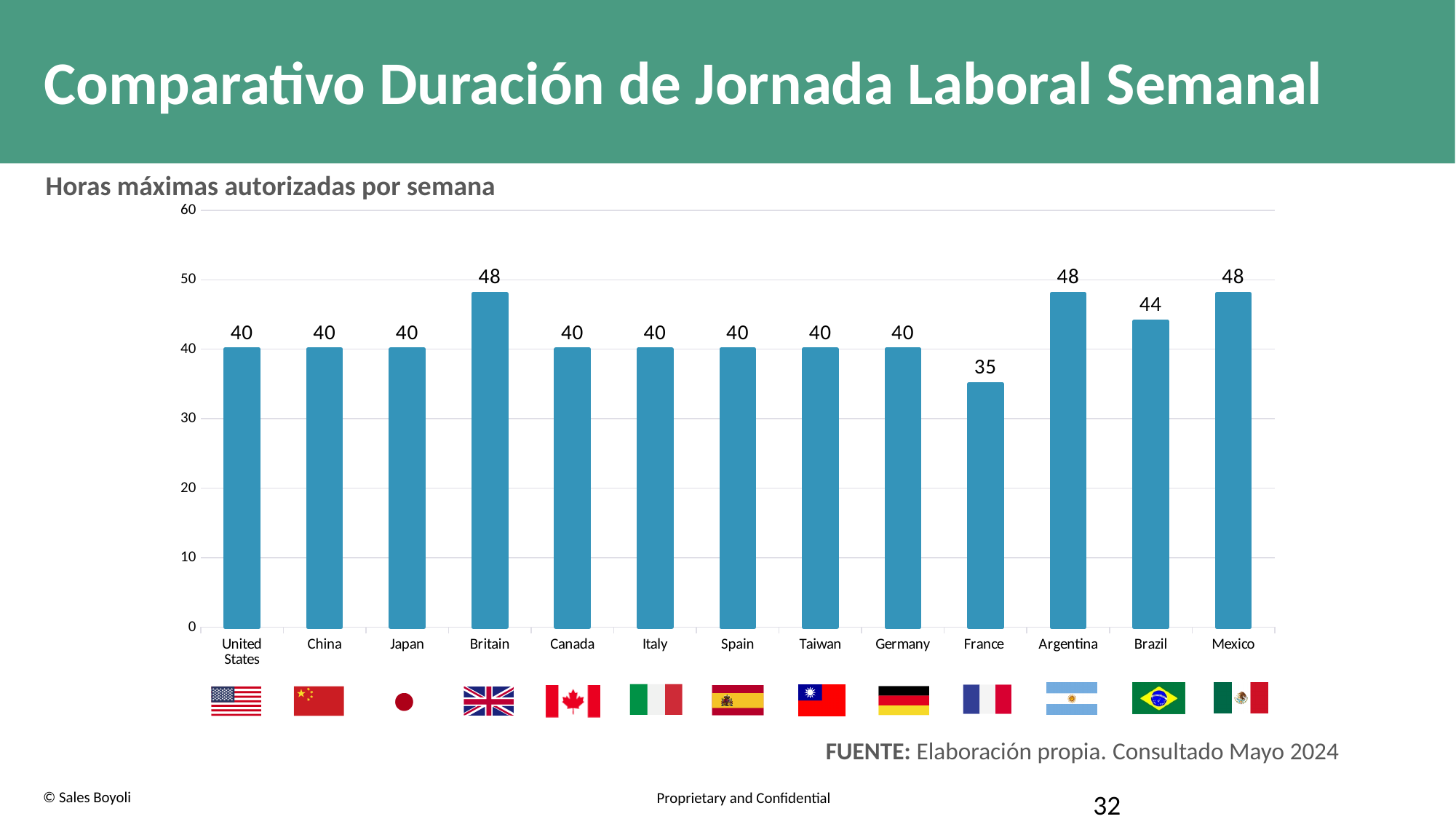
What is the value for Britain? 48 Which is larger, the value for Argentina or the value for Brazil? Argentina What is the value for Brazil? 44 What kind of chart is shown on the slide? bar chart What is the difference between the values for Brazil and Canada? 4 What is the subtitle shown above the chart? Horas máximas autorizadas por semana How many countries are shown on the chart? 13 What is the difference between the values for Mexico and France? 13 What is the value for France? 35 Is the value for France greater or less than 40? less Which country has the lowest value? France What is the value for Germany? 40